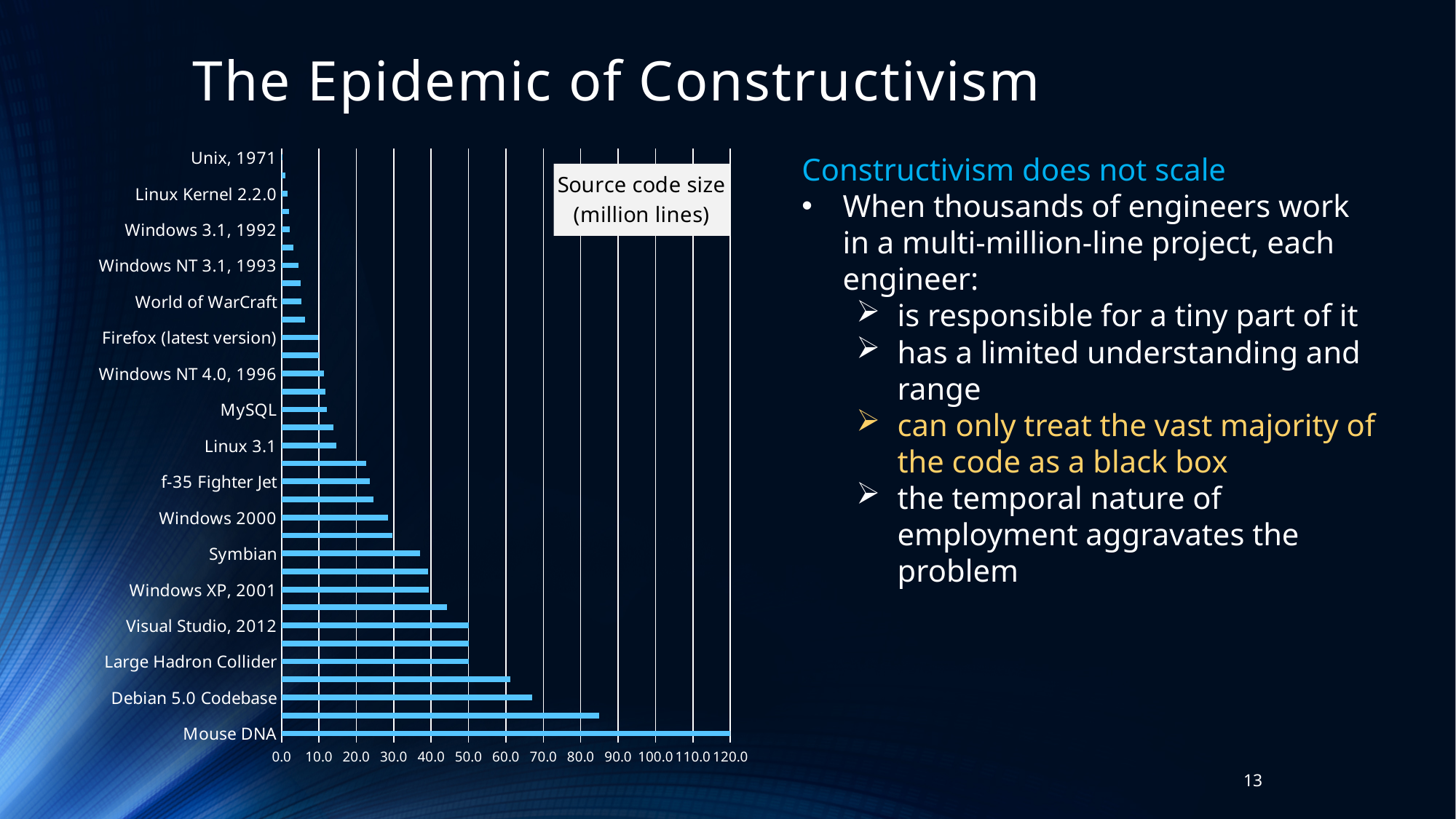
Which has a larger source code size, Windows 2000 or Linux 3.1? Windows 2000 Is the value for Windows 2000 greater or less than 40.0? less Is the value for Debian 5.0 Codebase greater or less than 60.0? greater Is the value for Firefox (latest version) greater or less than 20.0? less What kind of chart is shown on the slide? bar chart What unit does the chart's title box say the source code size is measured in? million lines Which category has the largest source code size in the chart? Mouse DNA Which has a larger source code size, Debian 5.0 Codebase or Large Hadron Collider? Debian 5.0 Codebase Which labelled category has the smallest source code size in the chart? Unix, 1971